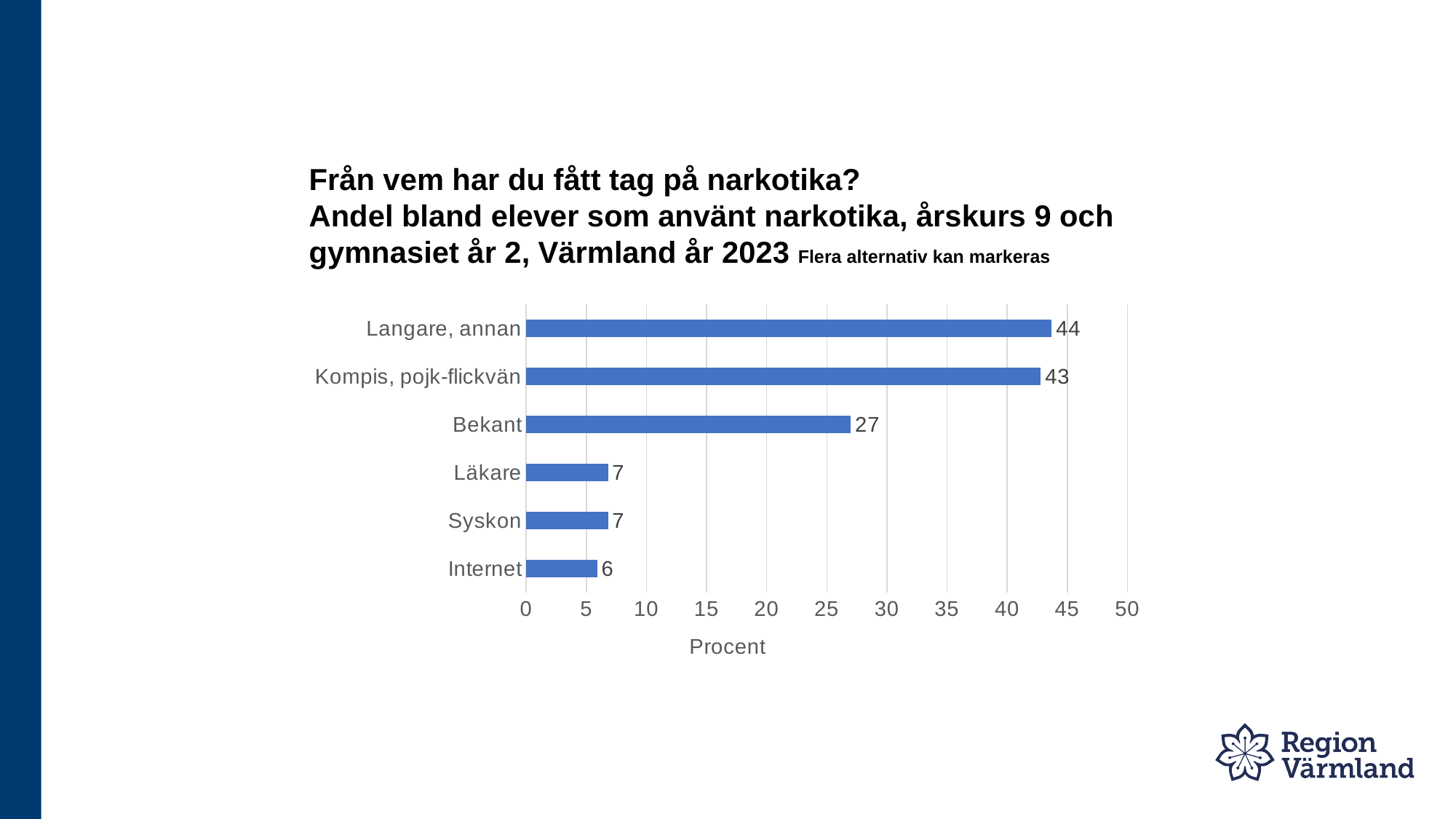
What is the value for Internet? 6 Which is larger, the value for Bekant or the value for Läkare? Bekant What is the value for Langare, annan? 44 What is the value for Kompis, pojk-flickvän? 43 What is the difference between the values for Kompis, pojk-flickvän and Internet? 37 What is the value for Bekant? 27 Which category has the lowest value? Internet What kind of chart is shown on the slide? Bar chart Which category has the highest value? Langare, annan What is the label of the horizontal axis? Procent How many categories are shown in the chart? 6 What is the difference between the values for Langare, annan and Bekant? 17